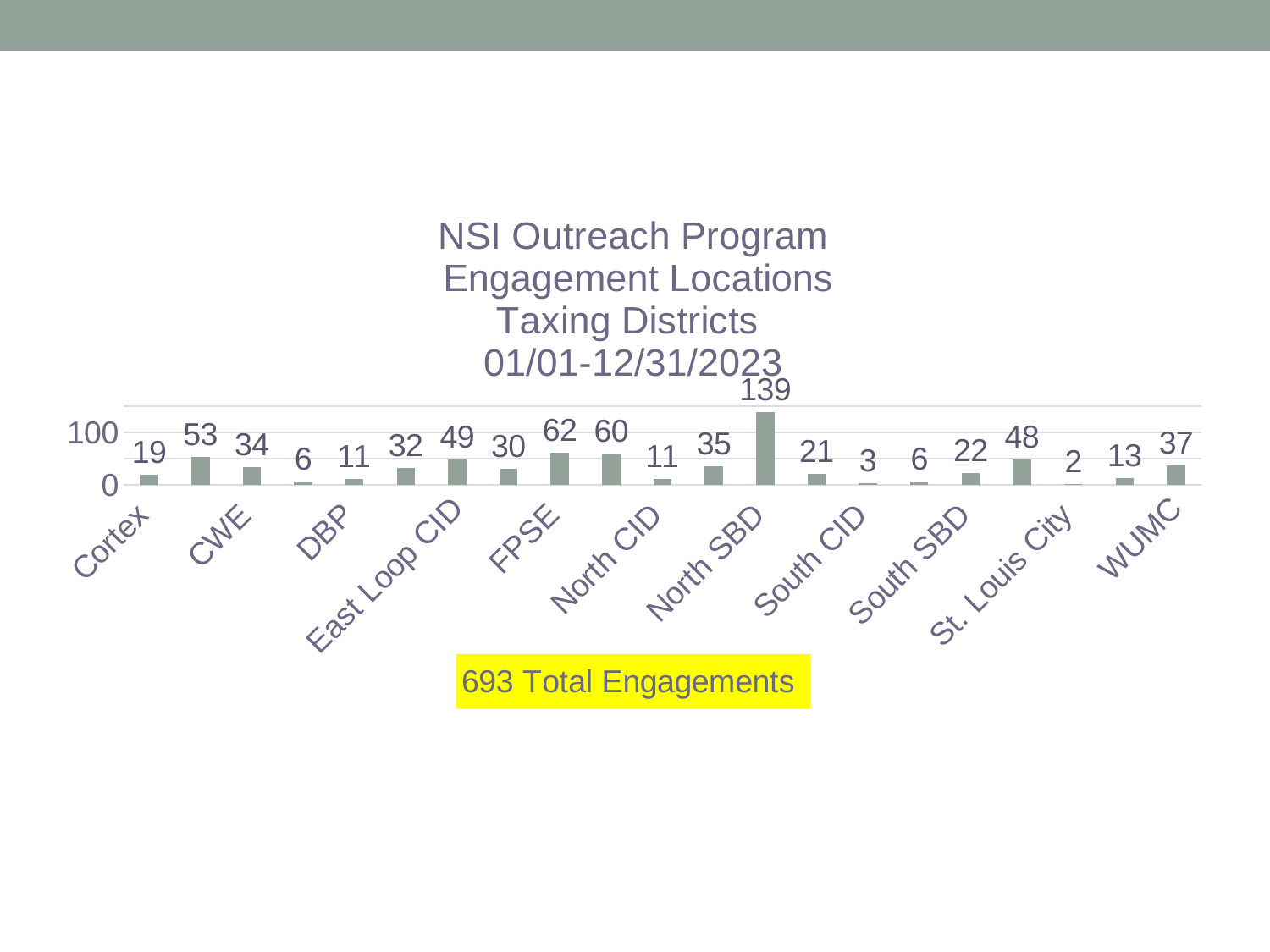
What is the highest value shown on the chart? 139 Which is larger, the value for Cortex or the value for WUMC? WUMC What total number of engagements is stated below the chart? 693 Total Engagements What is the value for North SBD? 139 Is the value for North SBD greater or less than 100? greater What is the difference between the value for North SBD and the value for Cortex? 120 What is the value for WUMC? 37 What is the value for Cortex? 19 What kind of chart is shown on the slide? bar chart Which taxing district has the highest number of engagements? North SBD What is the lowest value shown on the chart? 2 How many bars are plotted on the chart? 21